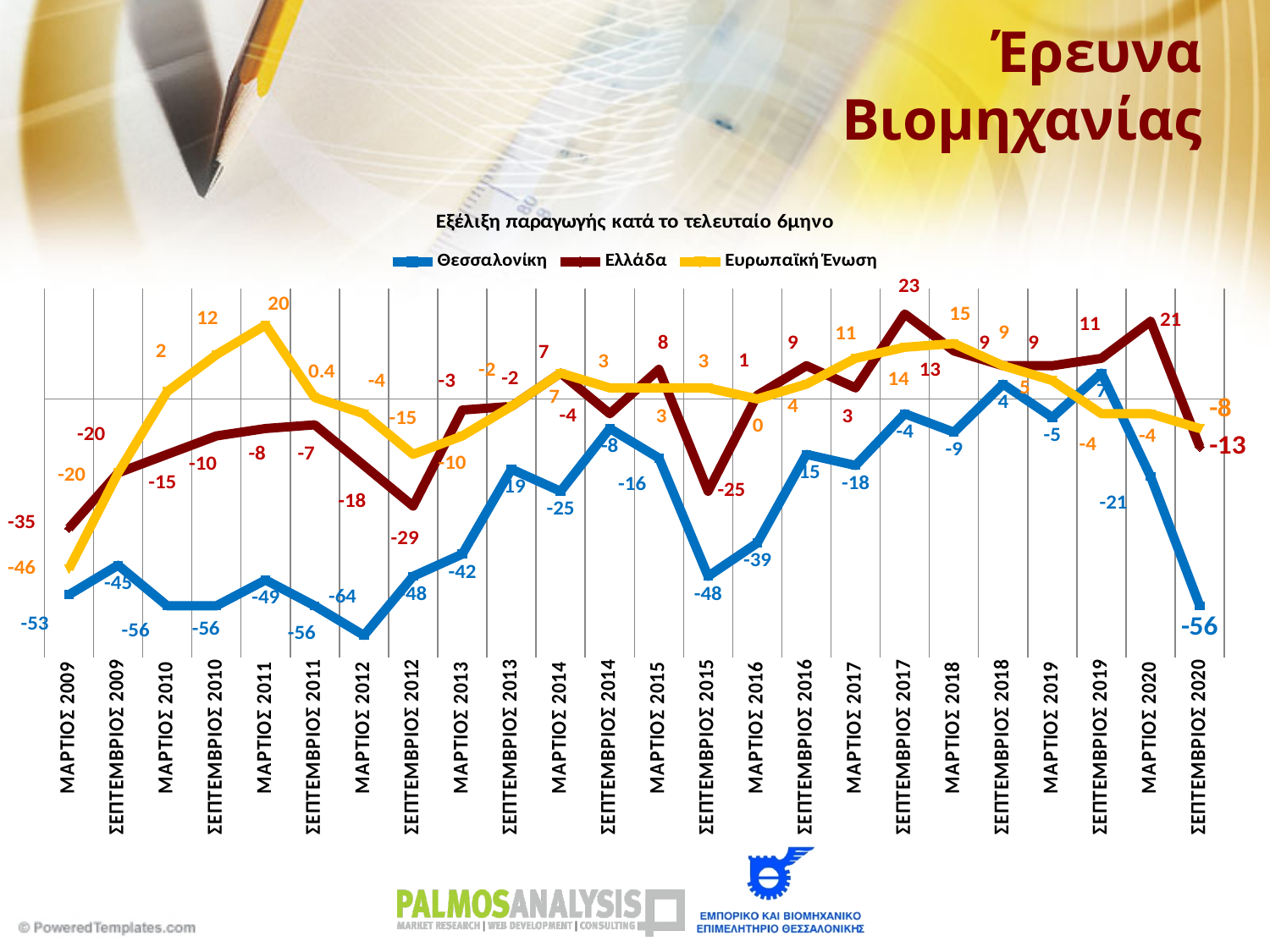
What is the value for Ευρωπαϊκή Ένωση in ΣΕΠΤΕΜΒΡΙΟΣ 2020? -8 In which period does the Ελλάδα series reach its highest value? ΣΕΠΤΕΜΒΡΙΟΣ 2017 How many time points are plotted along the x axis? 24 What is the title of the chart? Εξέλιξη παραγωγής κατά το τελευταίο 6μηνο By how much did the Ελλάδα value fall from ΜΑΡΤΙΟΣ 2020 to ΣΕΠΤΕΜΒΡΙΟΣ 2020? 34 What is the value for Ελλάδα in ΣΕΠΤΕΜΒΡΙΟΣ 2020? -13 How many series does the legend list? 3 What is the highest value of the Ευρωπαϊκή Ένωση series, and in which period? 20, ΜΑΡΤΙΟΣ 2011 What kind of chart is shown on the slide? line chart In which period does the Θεσσαλονίκη series reach its lowest value? ΜΑΡΤΙΟΣ 2012 What is the value for Θεσσαλονίκη in ΣΕΠΤΕΜΒΡΙΟΣ 2020? -56 Which series has the larger value in ΣΕΠΤΕΜΒΡΙΟΣ 2020, Ελλάδα or Θεσσαλονίκη? Ελλάδα